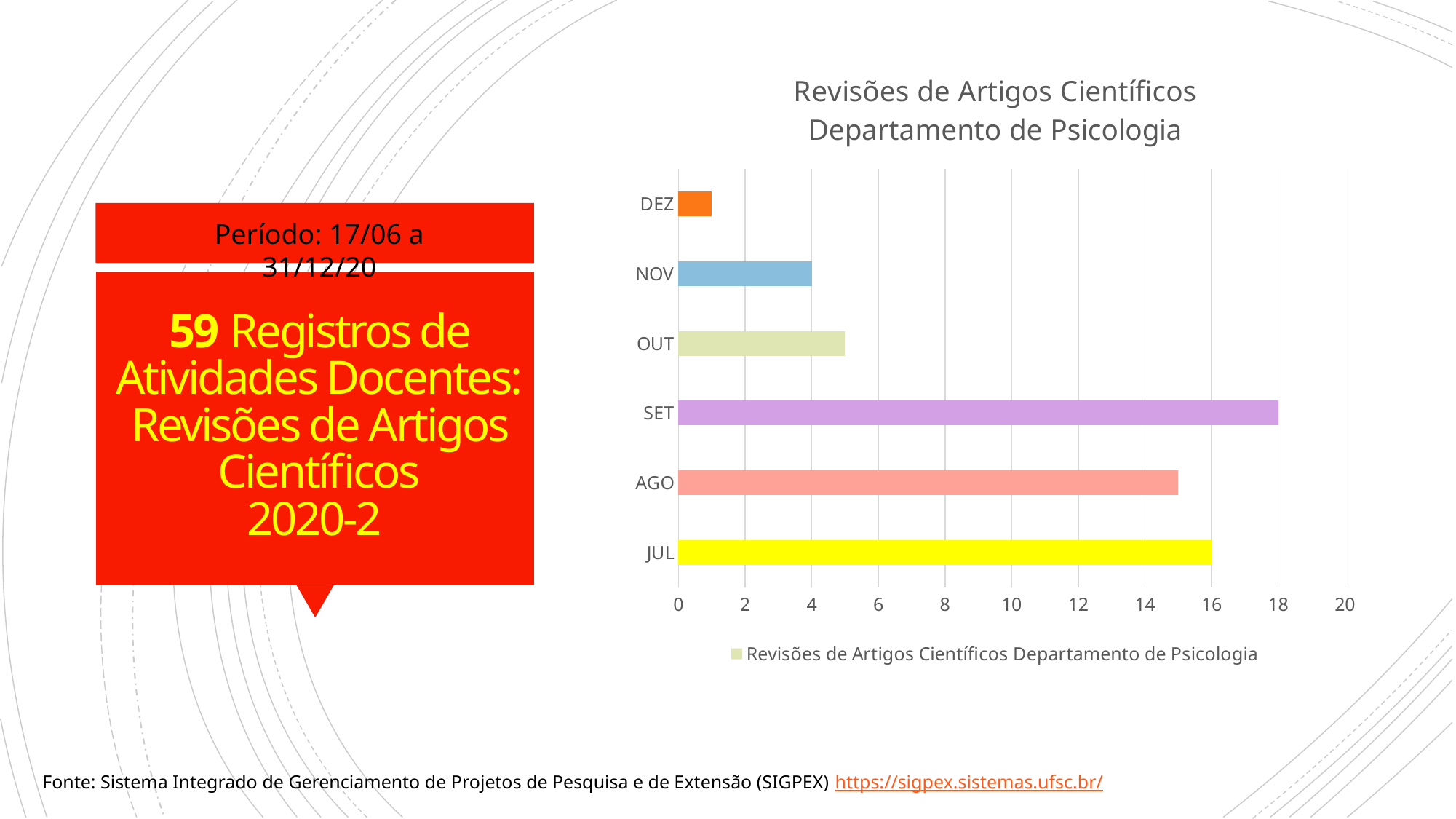
What is the value for NOV in the chart? 4 How many months (categories) are plotted in the chart? 6 What is the value for SET in the chart? 18 What is the value for JUL in the chart? 16 What is the difference between the values for SET and JUL? 2 Is the value for OUT greater or less than 6? less Which is larger, the value for SET or the value for AGO? SET Which month has the highest number of Revisões de Artigos Científicos? SET What type of chart is shown on the slide? bar chart How many series does the chart legend list? 1 Is the value for AGO greater or less than 14? greater Which month has the lowest number of Revisões de Artigos Científicos? DEZ